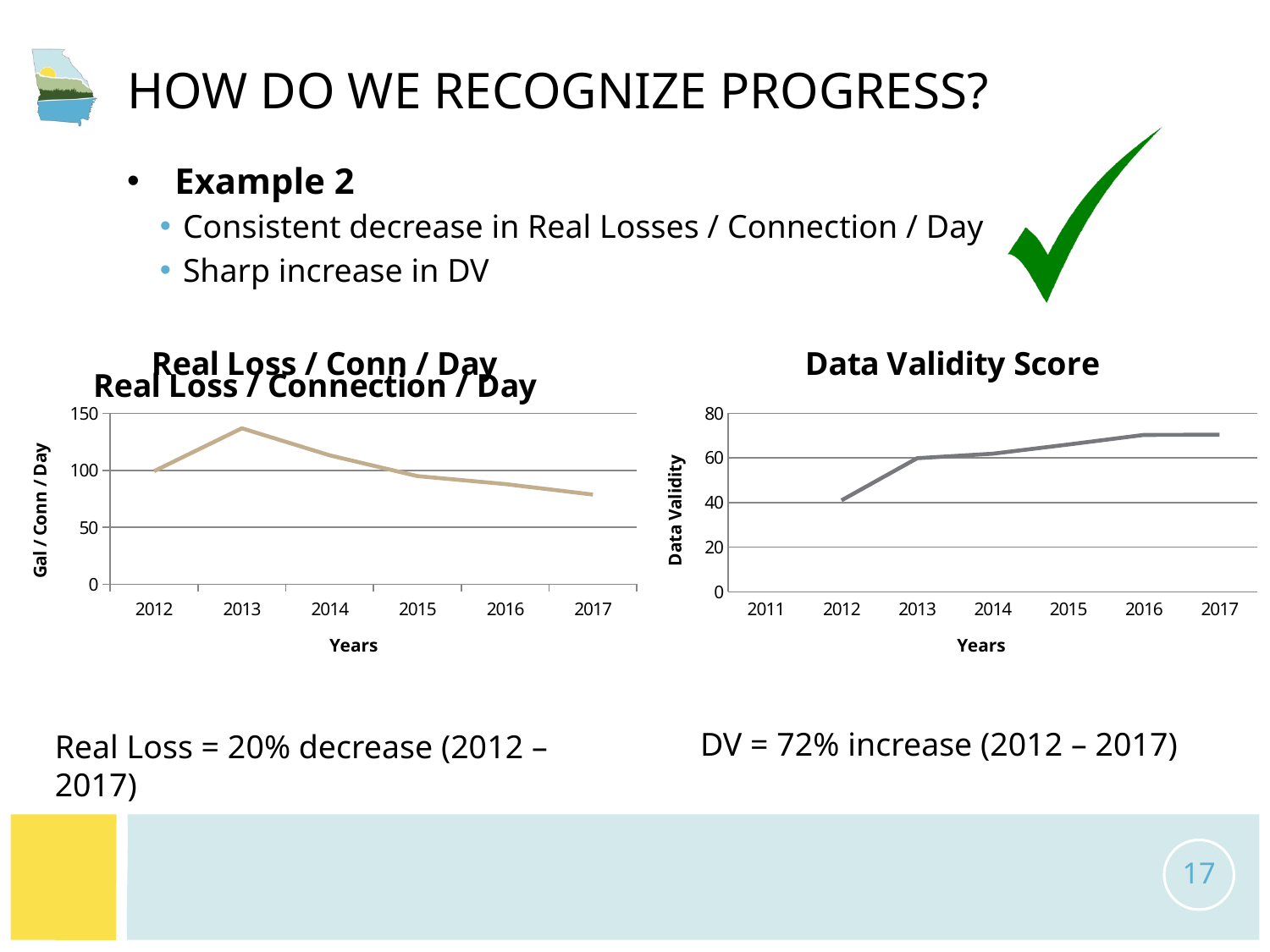
In the Real Loss / Conn / Day chart, is the value for 2017 greater or less than 100? less In the Real Loss / Conn / Day chart, is the value for 2013 greater or less than 100? greater In the Data Validity Score chart, is the value for 2012 greater or less than 60? less In the Real Loss / Conn / Day chart, do the values rise or fall from 2013 to 2017? fall What kind of chart is the Real Loss / Conn / Day chart on the left? line chart In the Real Loss / Conn / Day chart, which year has the highest value? 2013 In the Data Validity Score chart, which is larger, the value for 2012 or the value for 2017? 2017 What is the y-axis title of the Real Loss / Conn / Day chart? Gal / Conn / Day What kind of chart is the Data Validity Score chart on the right? line chart In the Real Loss / Conn / Day chart, how many years are shown on the x axis? 6 In the Real Loss / Conn / Day chart, which year has the lowest value? 2017